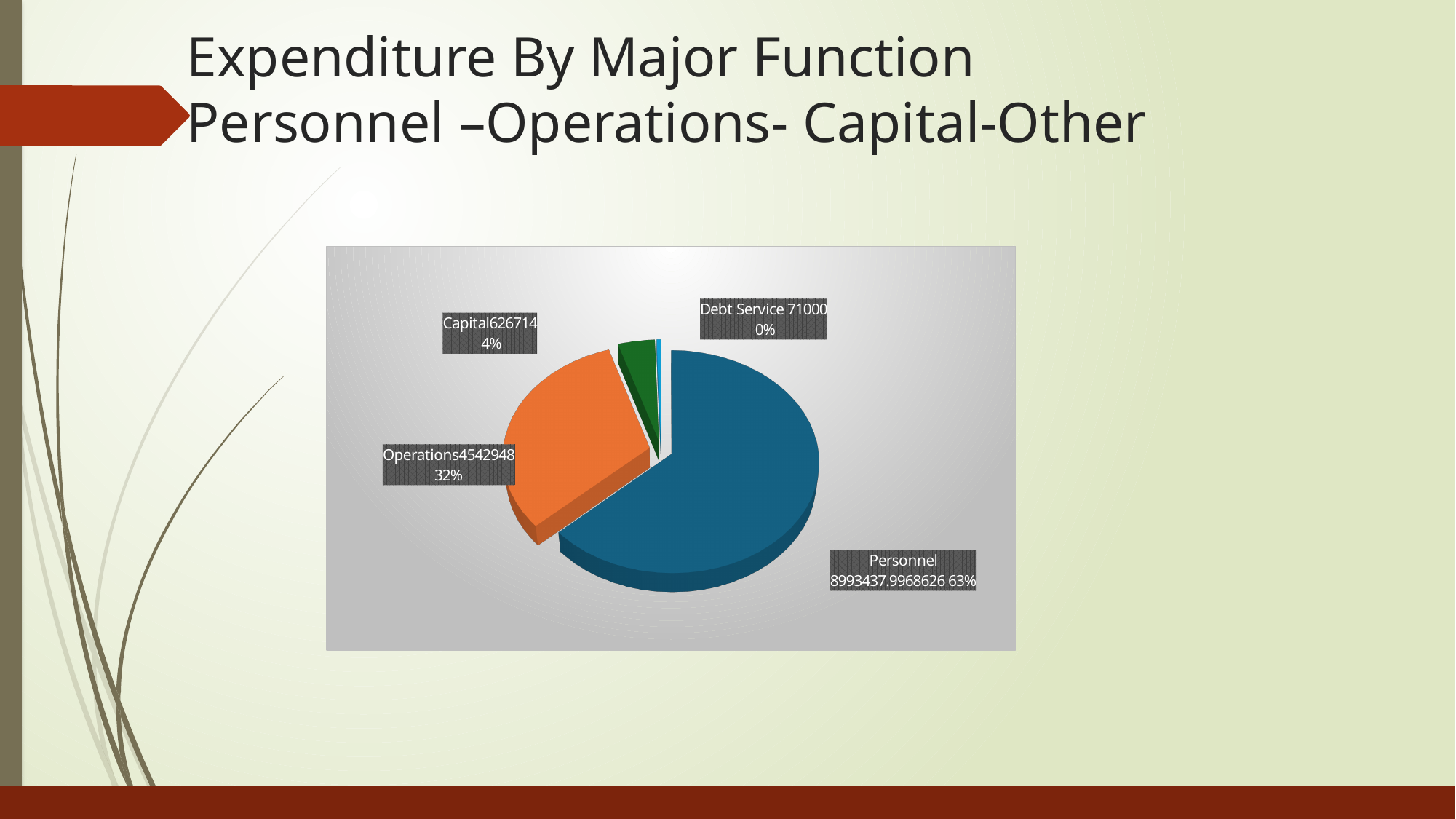
What is the value shown for Capital? 626714 Which category has the largest slice of the pie? Personnel How many slices does the pie chart have? 4 What is the difference between the values for Operations and Capital? 3916234 What share of the pie does Operations represent? 32% What share of the pie does Personnel represent? 63% Which is larger, the value for Operations or the value for Capital? Operations Which category has the smallest slice of the pie? Debt Service What is the value shown for Debt Service? 71000 What kind of chart is shown on the slide? Pie chart What share of the pie does Capital represent? 4% What is the value shown for Operations? 4542948